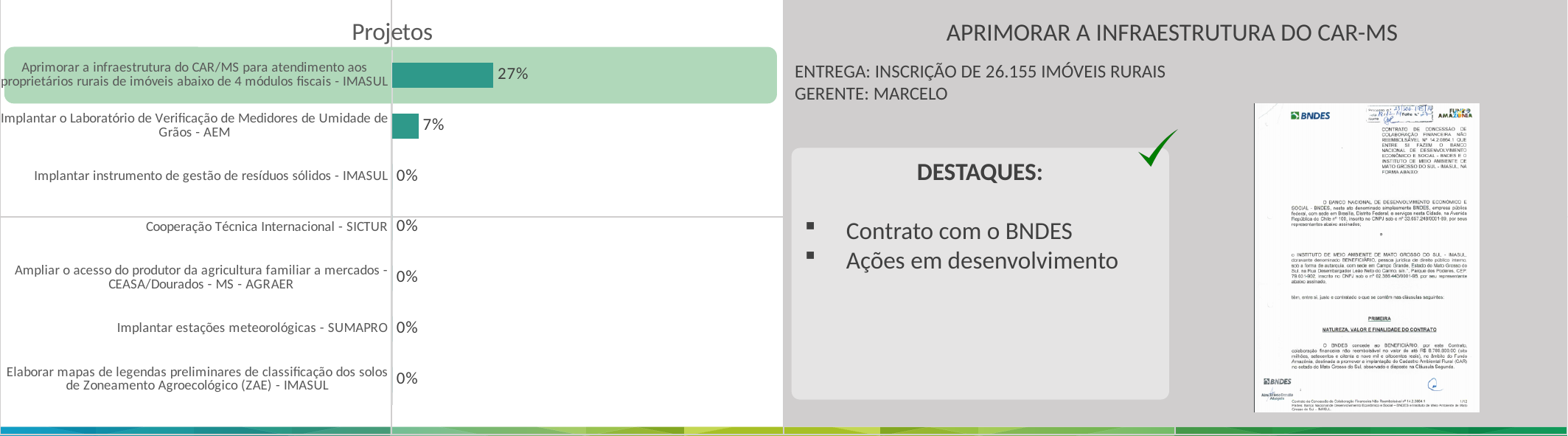
What type of chart is shown under the title "Projetos"? bar chart How many projects in the "Projetos" chart have a value of 0%? 5 What is the difference between the value for the CAR/MS infrastructure project (IMASUL) and the Laboratório de Verificação de Medidores de Umidade de Grãos project (AEM)? 20% What is the value for "Implantar estações meteorológicas - SUMAPRO"? 0% Which is larger: the value for "Implantar o Laboratório de Verificação de Medidores de Umidade de Grãos - AEM" or for "Implantar instrumento de gestão de resíduos sólidos - IMASUL"? Implantar o Laboratório de Verificação de Medidores de Umidade de Grãos - AEM What is the title of the chart on the left side of the slide? Projetos What is the value for "Elaborar mapas de legendas preliminares de classificação dos solos de Zoneamento Agroecológico (ZAE) - IMASUL"? 0% How many projects (categories) are listed in the "Projetos" chart? 7 What is the value for "Aprimorar a infraestrutura do CAR/MS para atendimento aos proprietários rurais de imóveis abaixo de 4 módulos fiscais - IMASUL"? 27% Which project has the highest value in the "Projetos" chart? Aprimorar a infraestrutura do CAR/MS para atendimento aos proprietários rurais de imóveis abaixo de 4 módulos fiscais - IMASUL What is the value for "Cooperação Técnica Internacional - SICTUR"? 0% What is the value for "Implantar o Laboratório de Verificação de Medidores de Umidade de Grãos - AEM"? 7%